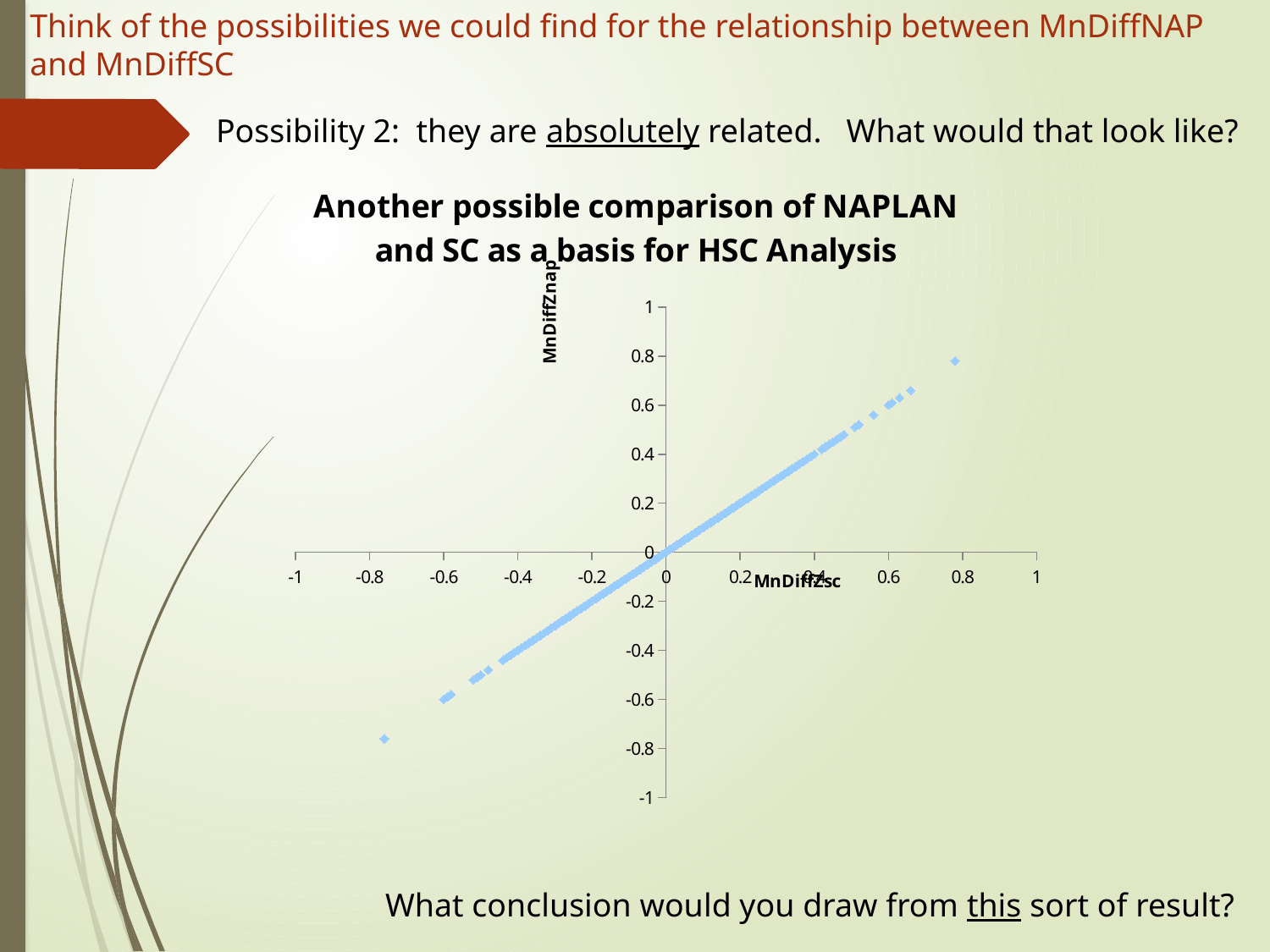
Is the MnDiffZnap value of the highest plotted point greater or less than 0.6? greater Is the MnDiffZnap value of the lowest plotted point greater or less than -0.6? less Is the MnDiffZsc value of the rightmost plotted point greater or less than 0.6? greater As MnDiffZsc increases along the x axis, do the MnDiffZnap values rise or fall? Rise What kind of chart is shown on the slide? Scatter chart What is the label on the horizontal axis of the chart? MnDiffZsc What is the title of the chart? Another possible comparison of NAPLAN and SC as a basis for HSC Analysis